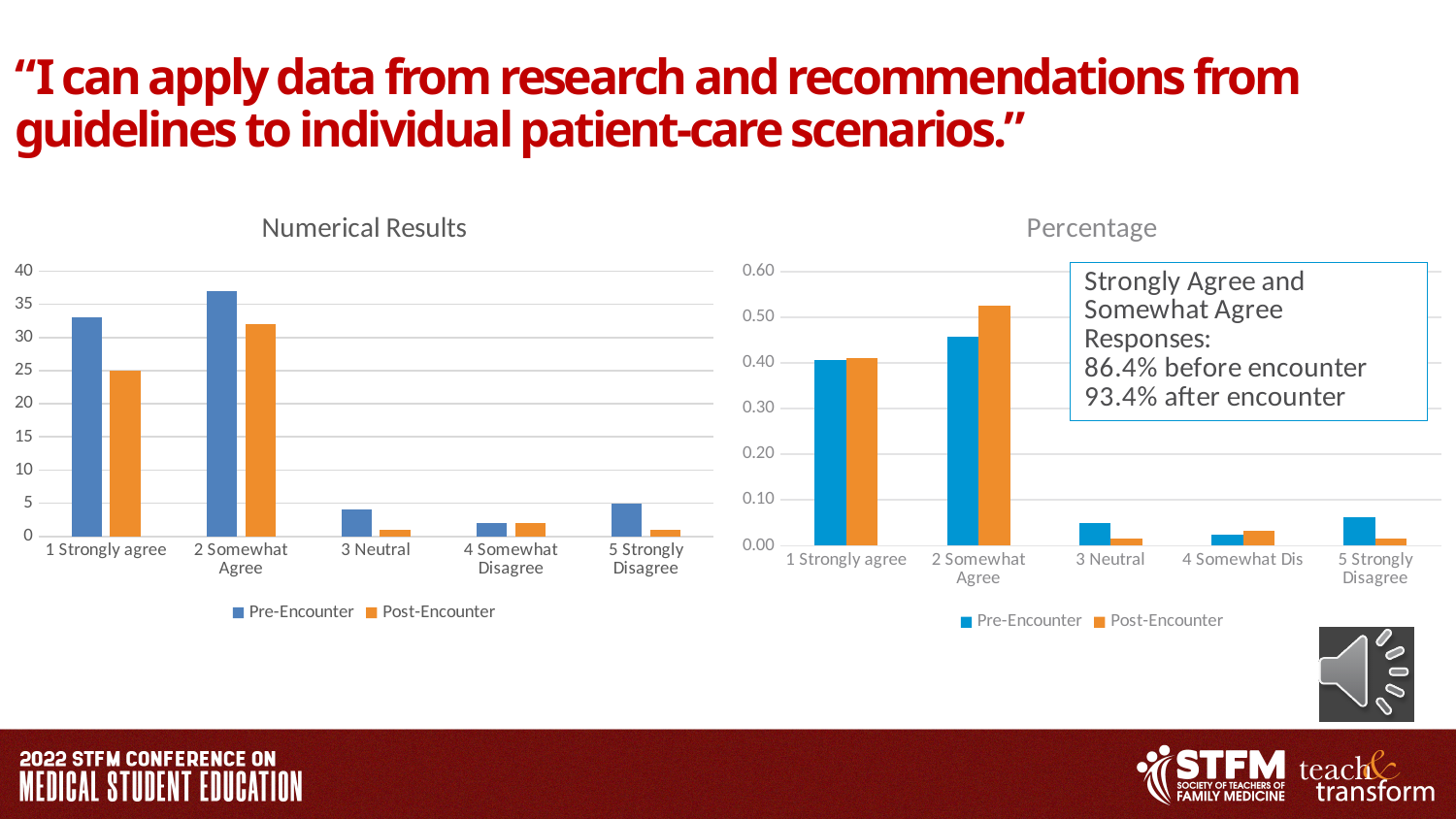
In the Numerical Results chart, what is the Post-Encounter value for 1 Strongly agree? 25 In the Numerical Results chart, for 1 Strongly agree, which is larger: Pre-Encounter or Post-Encounter? Pre-Encounter What kind of chart is the Numerical Results chart? bar chart In the Numerical Results chart, which category has the highest Pre-Encounter value? 2 Somewhat Agree In the Numerical Results chart, is the Pre-Encounter value for 2 Somewhat Agree greater or less than 35? greater In the Percentage chart, for 2 Somewhat Agree, which is larger: Pre-Encounter or Post-Encounter? Post-Encounter How many series does the legend of the Numerical Results chart list? 2 What is the title of the chart on the right side of the slide? Percentage In the Percentage chart, is the Post-Encounter value for 2 Somewhat Agree greater or less than 0.50? greater According to the text box on the Percentage chart, what share of responses were Strongly Agree or Somewhat Agree before the encounter? 86.4% How many response categories are shown on the x axis of the Numerical Results chart? 5 In the Percentage chart, which category has the lowest Pre-Encounter value? 4 Somewhat Dis